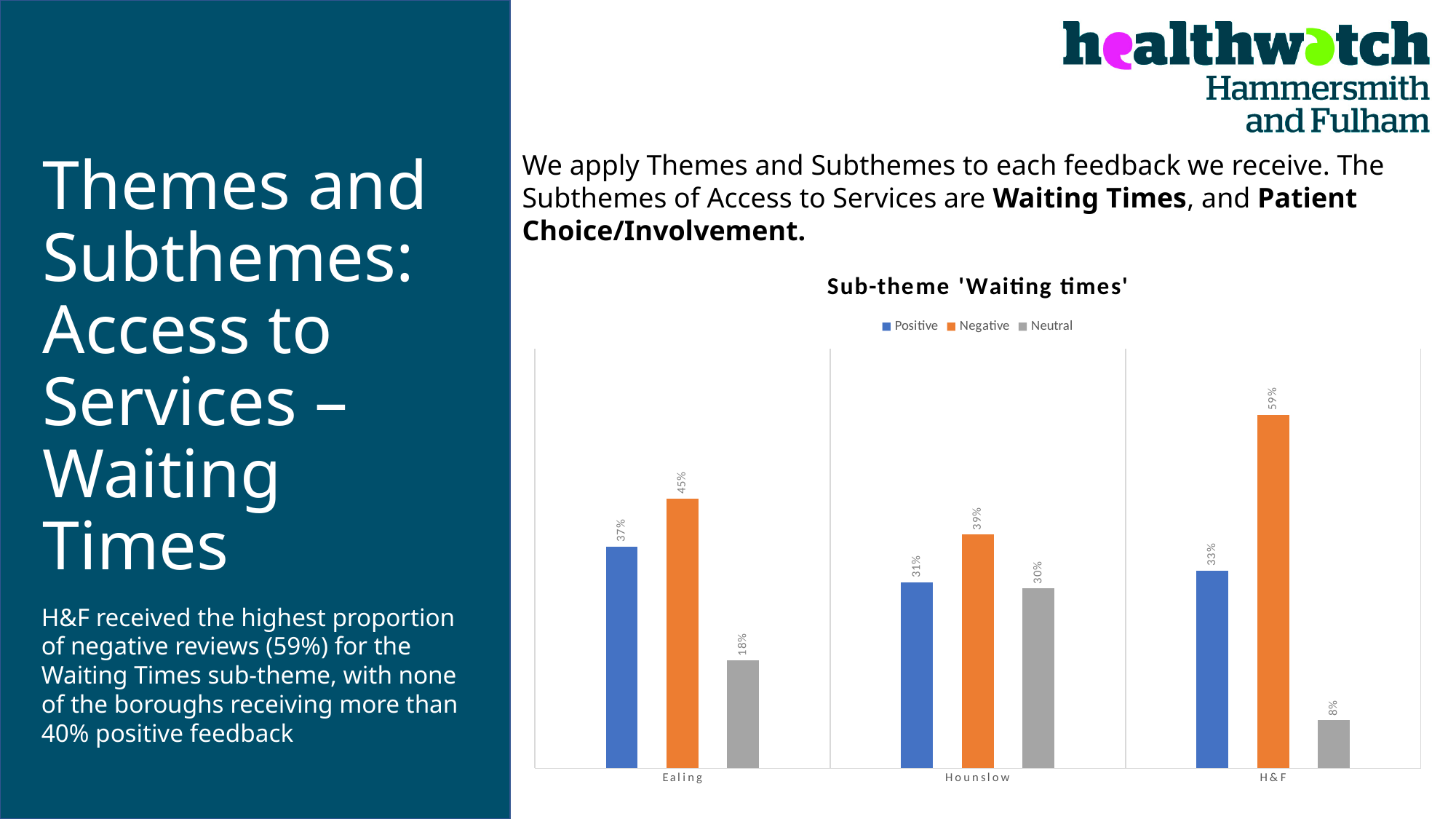
What is the Neutral value for Hounslow? 30% What kind of chart is shown? Bar chart What is the difference between the Negative and Positive values for H&F? 26% Which borough has the lowest Neutral value? H&F How many boroughs are shown on the x axis? 3 What is the Negative value for H&F? 59% Which is larger, the Positive value for Ealing or the Positive value for Hounslow? Ealing How many series does the legend list? 3 Which colour represents the Negative series? Orange Which borough has the highest Negative value? H&F What is the title of the chart? Sub-theme 'Waiting times' What is the Positive value for Ealing? 37%